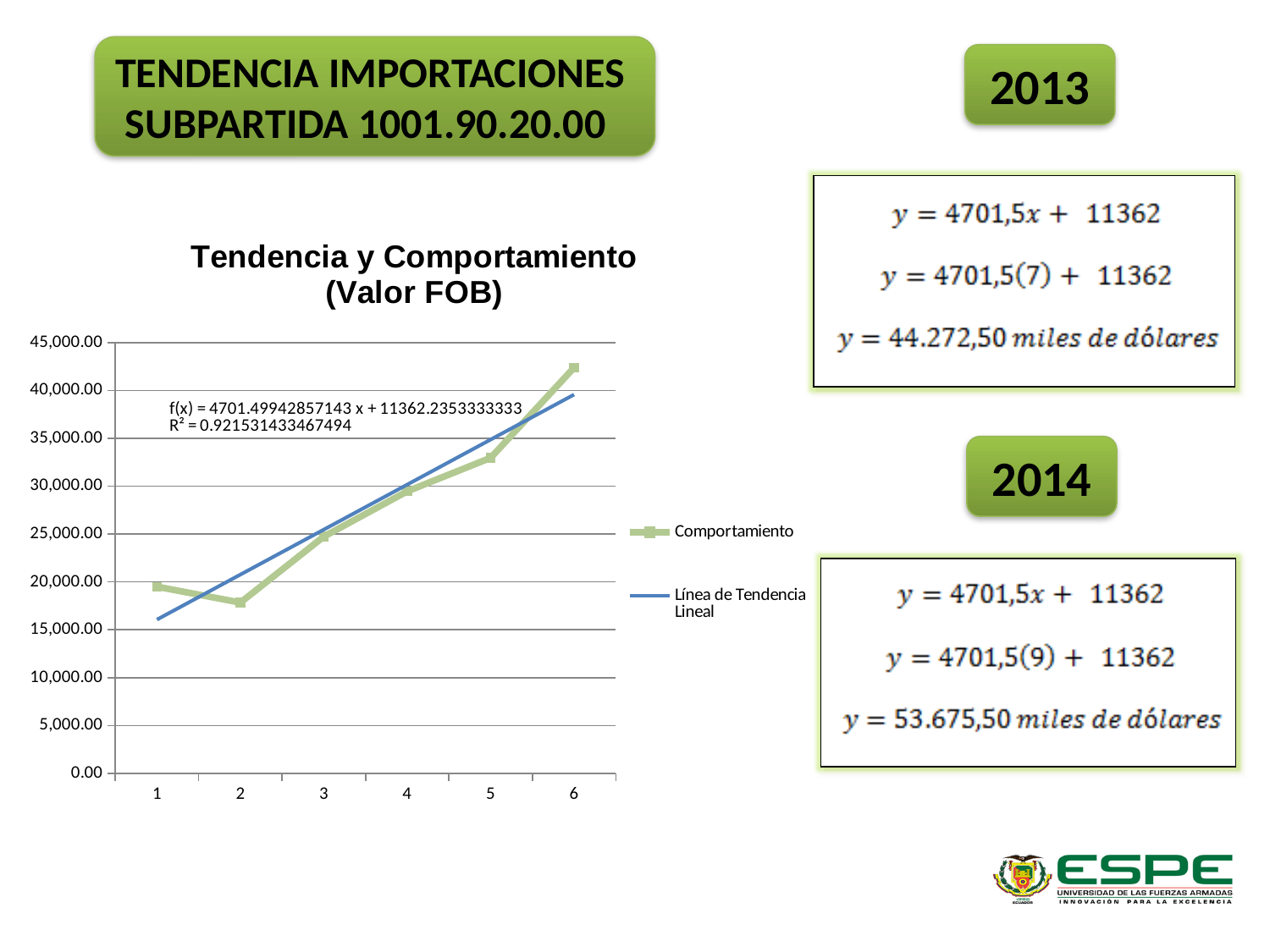
At which x-axis point does the Comportamiento series reach its highest value? 6 At which x-axis point does the Comportamiento series reach its lowest value? 2 Is the Comportamiento value at point 2 greater or less than 20,000.00? less Is the Comportamiento value at point 4 greater or less than 25,000.00? greater What is the title of the chart? Tendencia y Comportamiento (Valor FOB) What R² value is printed on the chart for the linear trend line? 0.921531433467494 How many series does the chart legend list? 2 Which is larger for the Comportamiento series: the value at point 1 or the value at point 5? point 5 Do the Comportamiento values generally rise or fall from point 2 to point 6? rise How many points are plotted along the x axis for the Comportamiento series? 6 What kind of chart is shown on the slide? line chart Is the Comportamiento value at point 6 greater or less than 40,000.00? greater